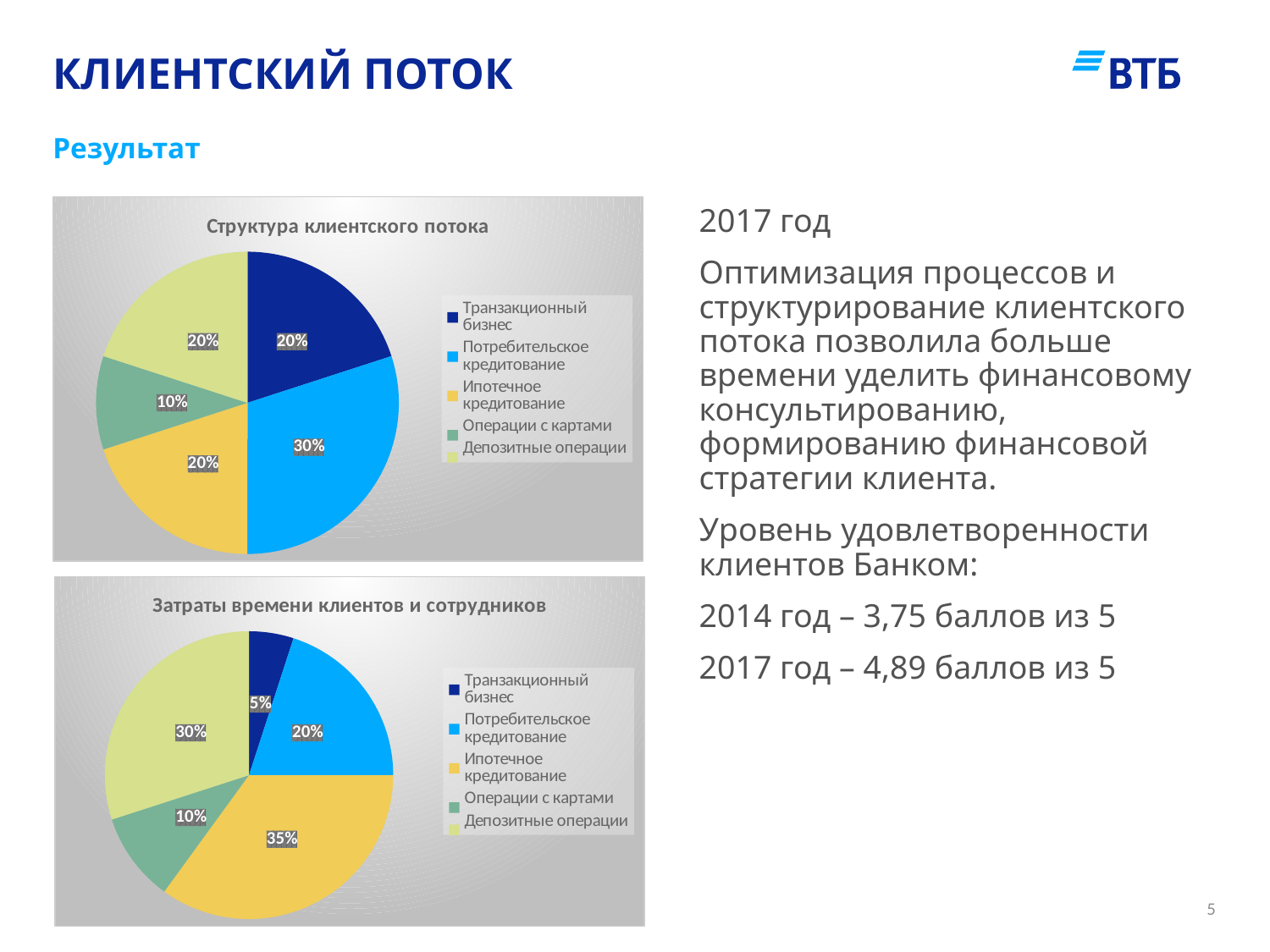
In the chart titled «Структура клиентского потока», which is larger: the share of «Потребительское кредитование» or the share of «Ипотечное кредитование»? Потребительское кредитование In the chart titled «Структура клиентского потока», what share does «Операции с картами» have? 10% In the chart titled «Затраты времени клиентов и сотрудников», what share does «Ипотечное кредитование» have? 35% In the chart titled «Затраты времени клиентов и сотрудников», which category has the smallest share? Транзакционный бизнес In the chart titled «Затраты времени клиентов и сотрудников», what share does «Транзакционный бизнес» have? 5% How many categories does the legend of the chart titled «Затраты времени клиентов и сотрудников» list? 5 In the chart titled «Структура клиентского потока», which category has the largest share? Потребительское кредитование What type of chart is the chart titled «Структура клиентского потока»? Pie chart In the chart titled «Затраты времени клиентов и сотрудников», which category has the largest share? Ипотечное кредитование In the chart titled «Затраты времени клиентов и сотрудников», what is the difference between the shares of «Ипотечное кредитование» and «Депозитные операции»? 5% In the chart titled «Структура клиентского потока», what share does «Потребительское кредитование» have? 30% In the chart titled «Структура клиентского потока», which category has the smallest share? Операции с картами